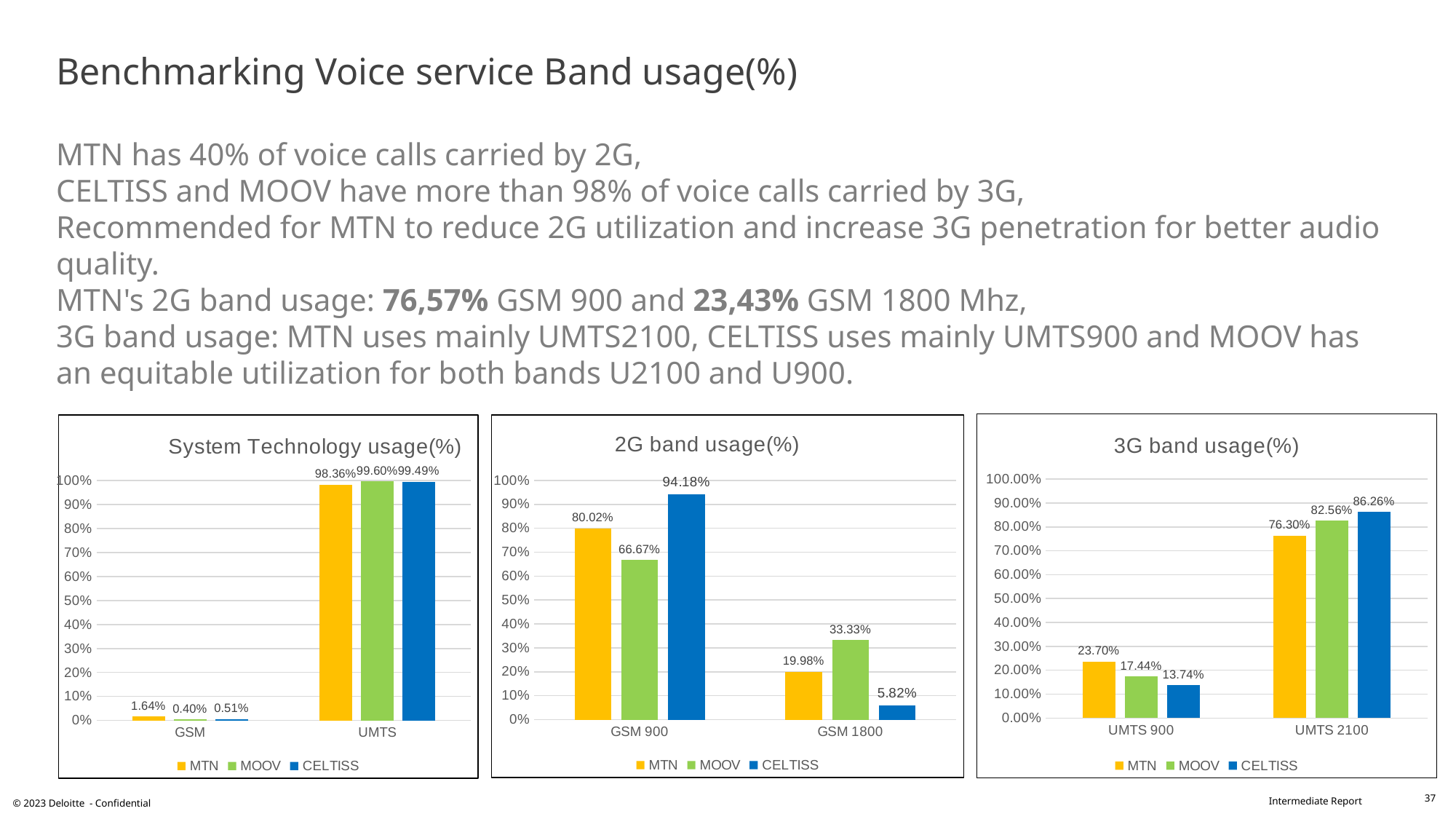
In the "2G band usage(%)" chart, is the MOOV value for GSM 900 greater or less than 70%? less In the "2G band usage(%)" chart, what is the value for CELTISS under GSM 900? 94.18% What kind of chart is the "3G band usage(%)" chart? Bar chart In the "2G band usage(%)" chart, which operator has the lowest value for GSM 1800? CELTISS In the "2G band usage(%)" chart, what is the difference between the MTN values for GSM 900 and GSM 1800? 60.04% In the "System Technology usage(%)" chart, how many series does the legend list? 3 In the "3G band usage(%)" chart, what is the value for MOOV under UMTS 2100? 82.56% In the "System Technology usage(%)" chart, what is the value for MTN under GSM? 1.64% In the "3G band usage(%)" chart, which operator has the highest value for UMTS 900? MTN In the "2G band usage(%)" chart, how many categories are shown on the x axis? 2 In the "System Technology usage(%)" chart, which operator has the highest value for UMTS? MOOV In the "3G band usage(%)" chart, which is larger for CELTISS: UMTS 900 or UMTS 2100? UMTS 2100